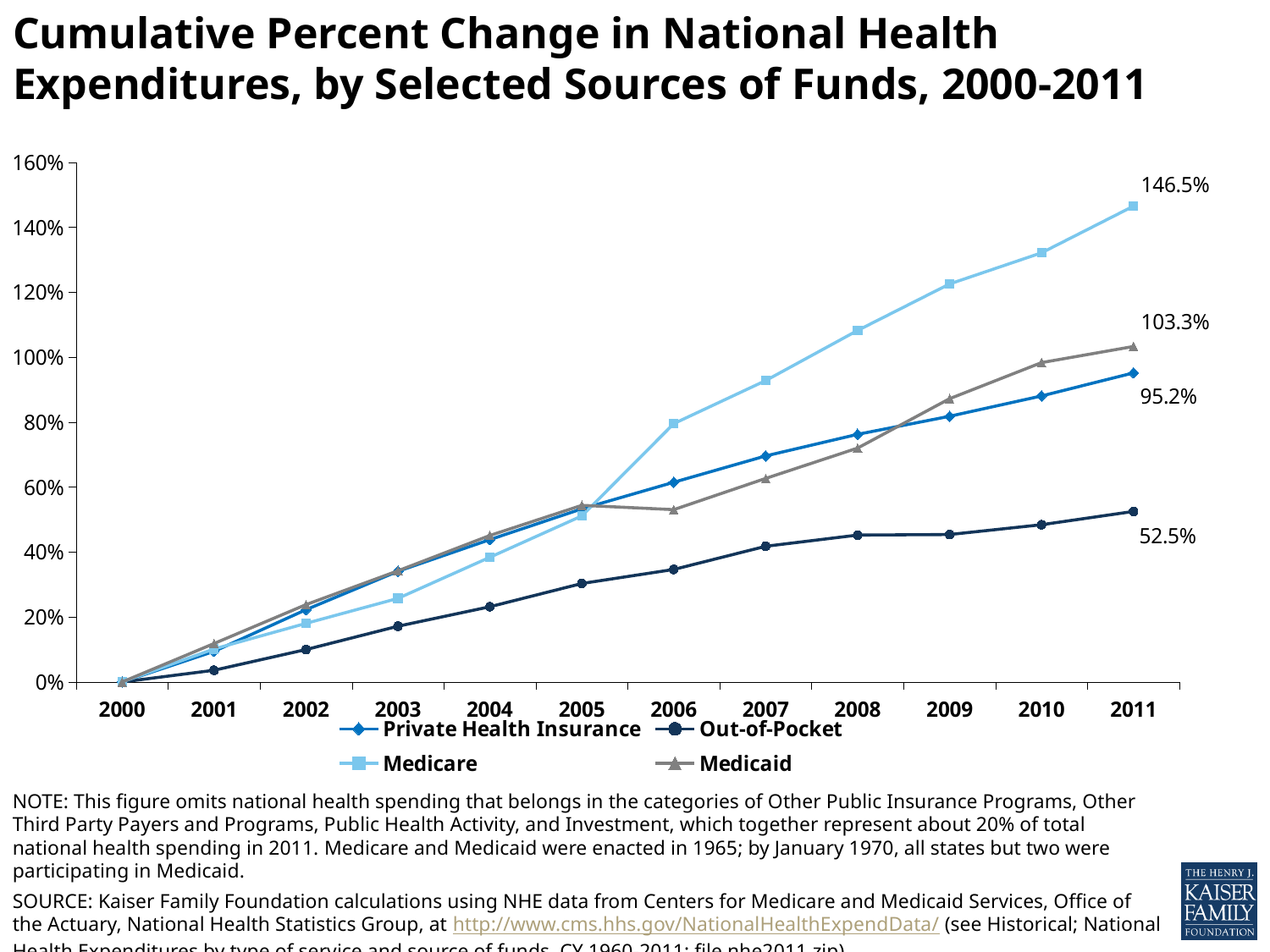
What kind of chart is shown on the slide? Line chart What is the cumulative percent change for Medicare in 2011? 146.5% Does the Medicare line rise or fall from 2000 to 2011? Rises What is the cumulative percent change for Private Health Insurance in 2011? 95.2% Which source of funds has the highest cumulative percent change in 2011? Medicare In 2011, which is larger: the value for Medicaid or the value for Private Health Insurance? Medicaid Which source of funds has the lowest cumulative percent change in 2011? Out-of-Pocket What is the cumulative percent change for Out-of-Pocket in 2011? 52.5% What is the cumulative percent change for Medicaid in 2011? 103.3% What is the difference between the 2011 values for Medicare and Out-of-Pocket? 94.0 percentage points How many series does the legend list? 4 Is the value for Medicare in 2008 greater or less than 100%? greater